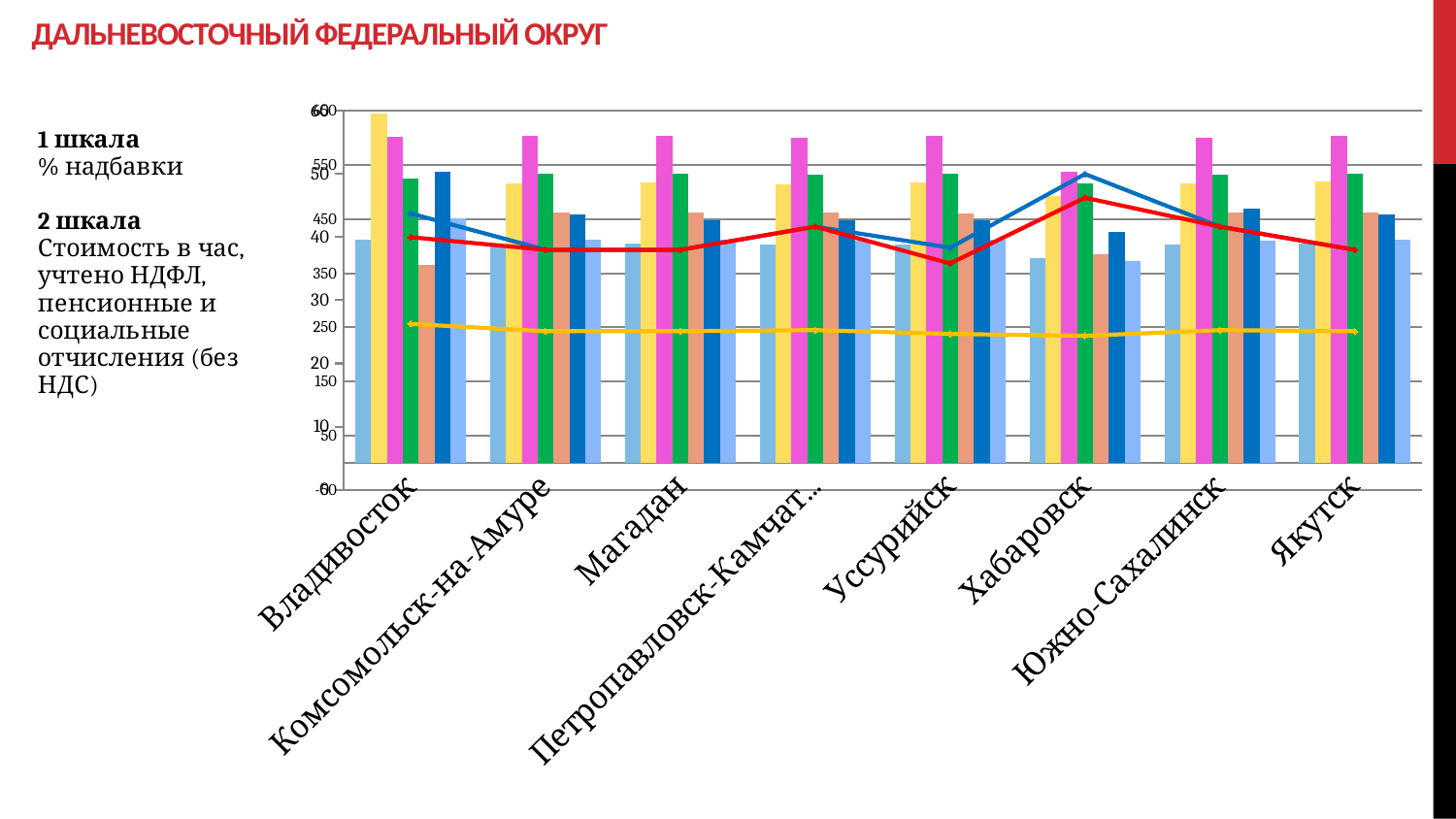
Is the yellow bar taller at Владивосток or at Хабаровск? Владивосток Is the value of the yellow line at Владивосток greater or less than 300? less What is the title of the slide containing the chart? ДАЛЬНЕВОСТОЧНЫЙ ФЕДЕРАЛЬНЫЙ ОКРУГ Is the red line higher at Хабаровск or at Уссурийск? Хабаровск Which city has the tallest bar on the chart? Владивосток At which city does the blue line reach its highest point? Хабаровск What kind of chart is shown on the slide? A combined bar and line chart At which city does the red line reach its highest point? Хабаровск How many cities (categories) are shown along the x axis of the chart? 8 How many lines are plotted on the chart? 3 How many bars are drawn for each city on the chart? 7 At Владивосток, is the pink bar or the orange bar taller? The pink bar